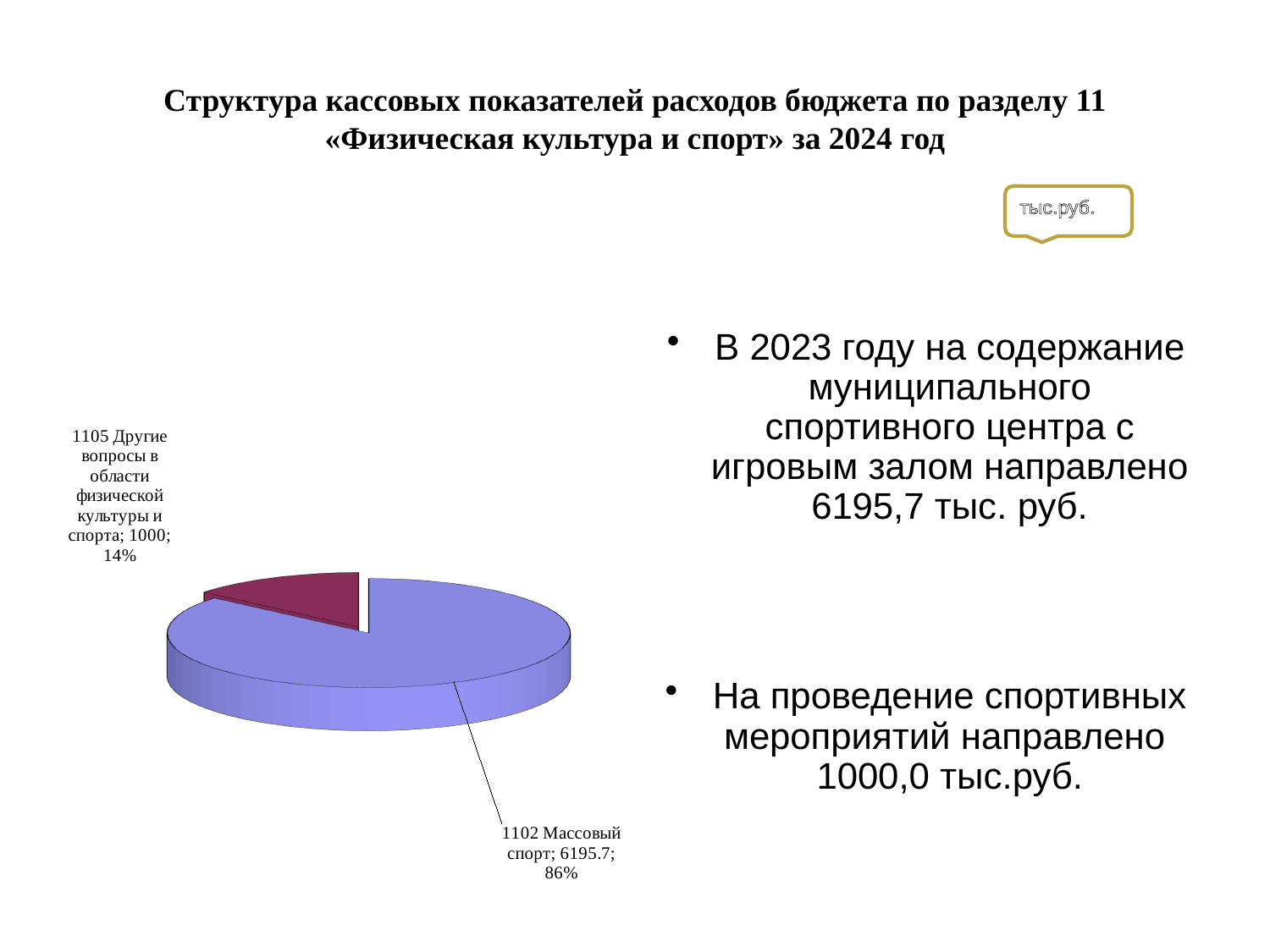
What kind of chart is shown on the slide? pie chart What share of the pie does "1102 Массовый спорт" take? 86% What is the difference between the values for "1102 Массовый спорт" and "1105 Другие вопросы в области физической культуры и спорта"? 5195.7 Which category has the smallest slice? 1105 Другие вопросы в области физической культуры и спорта What is the total of the two slices in the pie chart? 7195.7 What is the value for "1102 Массовый спорт"? 6195.7 How many slices does the pie chart have? 2 Which category has the largest slice? 1102 Массовый спорт What is the value for "1105 Другие вопросы в области физической культуры и спорта"? 1000 What unit is indicated in the callout box next to the chart? тыс.руб. What share of the pie does "1105 Другие вопросы в области физической культуры и спорта" take? 14% Which is larger: the value for "1102 Массовый спорт" or for "1105 Другие вопросы в области физической культуры и спорта"? 1102 Массовый спорт